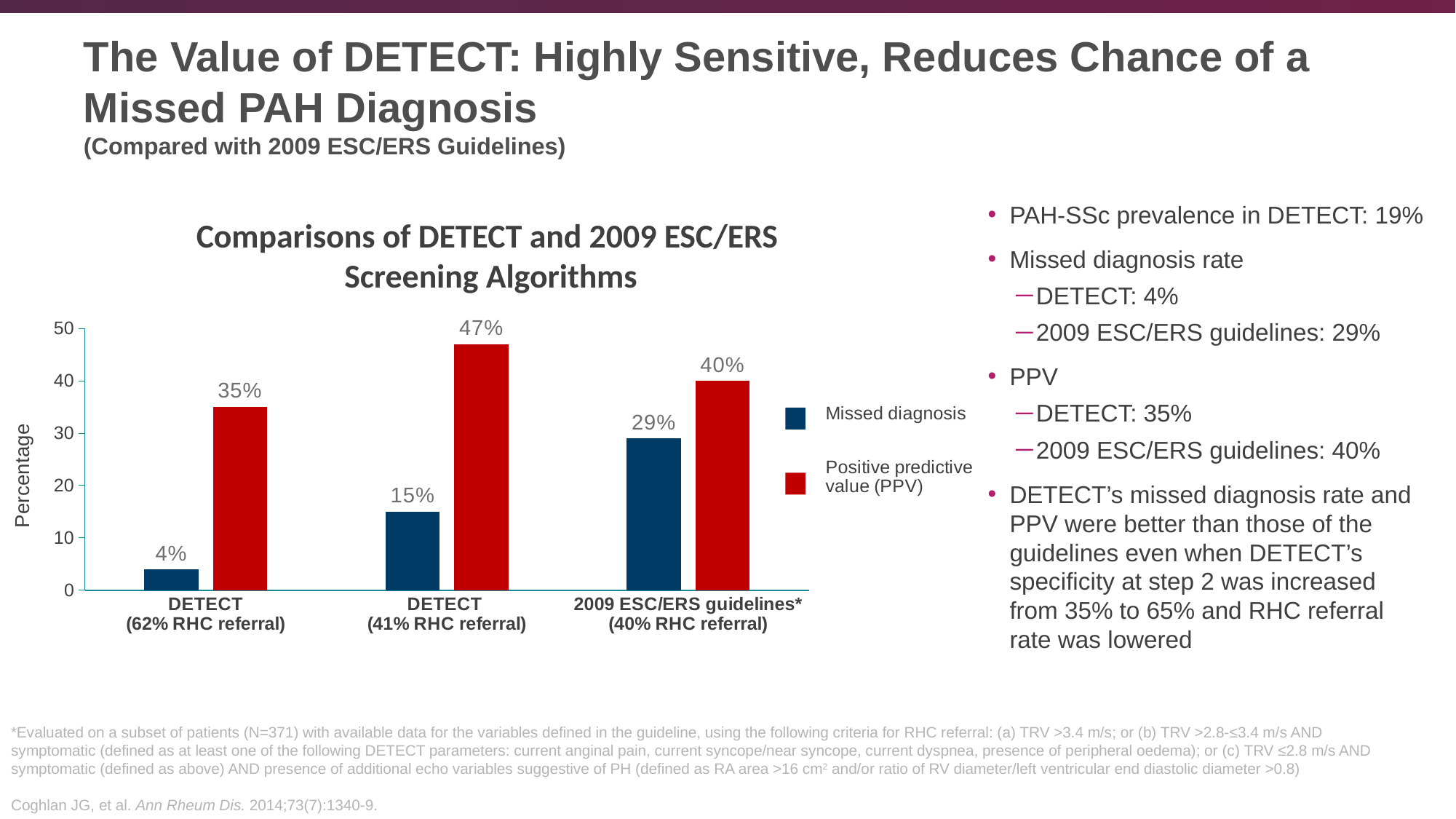
What is the positive predictive value (PPV) for DETECT (41% RHC referral)? 47% What is the difference in missed diagnosis between the 2009 ESC/ERS guidelines and DETECT (62% RHC referral)? 25% What type of chart is shown on the slide? Bar chart Which category has the highest positive predictive value (PPV)? DETECT (41% RHC referral) What is the title of the chart? Comparisons of DETECT and 2009 ESC/ERS Screening Algorithms How many series does the chart legend list? 2 What is the missed diagnosis value for the 2009 ESC/ERS guidelines (40% RHC referral)? 29% What is the difference between the PPV of DETECT (41% RHC referral) and the PPV of the 2009 ESC/ERS guidelines? 7% How many categories are shown on the x axis of the chart? 3 What is the missed diagnosis value for DETECT (62% RHC referral)? 4% Which is larger: the PPV for DETECT (62% RHC referral) or the PPV for the 2009 ESC/ERS guidelines? 2009 ESC/ERS guidelines Which category has the lowest missed diagnosis value? DETECT (62% RHC referral)